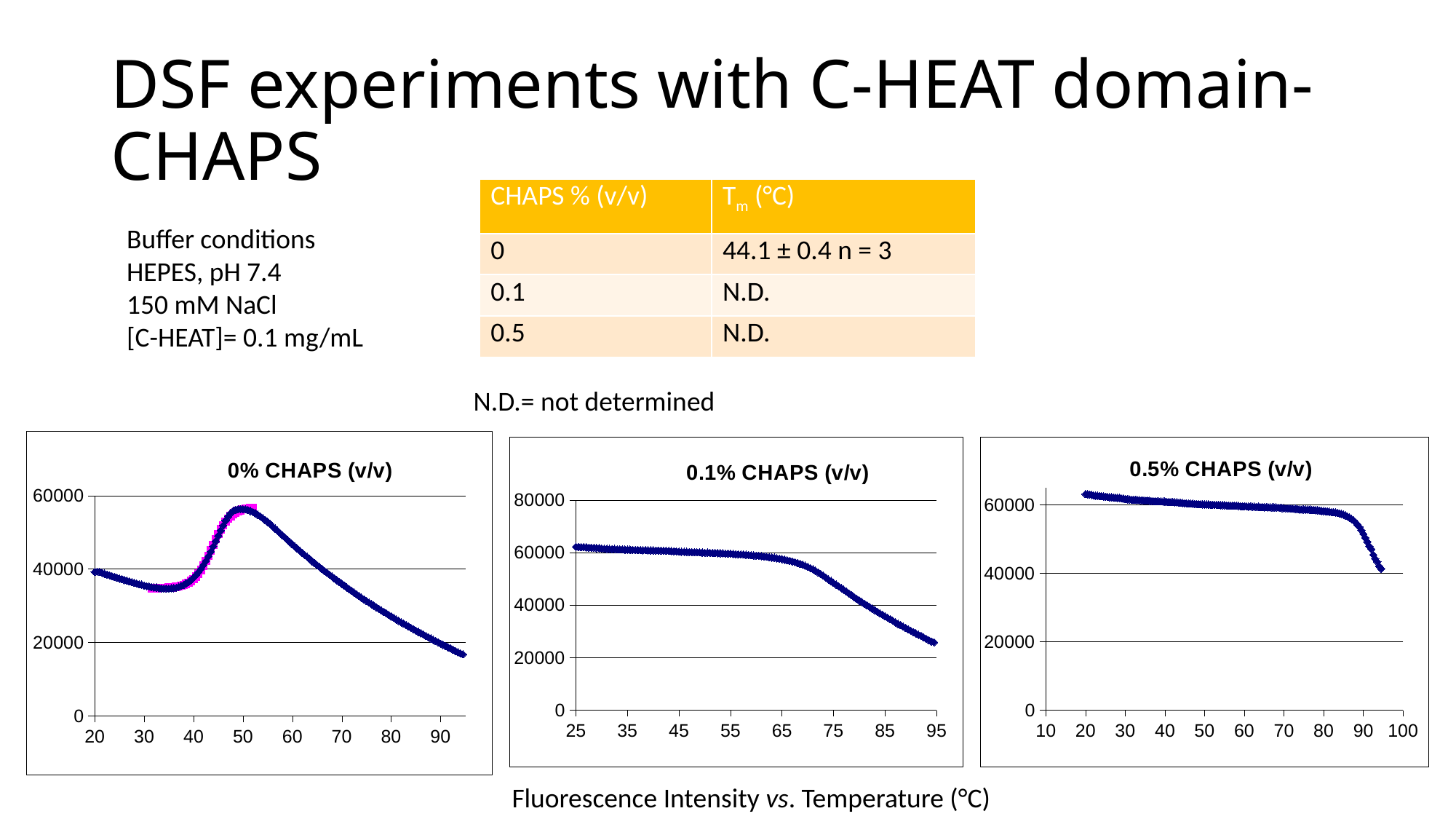
How many charts are shown on the slide? 3 In the '0.5% CHAPS (v/v)' chart, which is larger, the value at 20 or the value at 95? 20 What kind of chart is the '0% CHAPS (v/v)' chart? scatter chart What is the title of the rightmost chart? 0.5% CHAPS (v/v) In the '0% CHAPS (v/v)' chart, is the value at 50 greater or less than 60000? less In the '0% CHAPS (v/v)' chart, which x-axis tick is closest to the peak of the curve? 50 In the '0% CHAPS (v/v)' chart, is the value at 70 greater or less than 40000? less In the '0.1% CHAPS (v/v)' chart, do the values rise or fall as temperature increases along the x axis? fall In the '0.1% CHAPS (v/v)' chart, is the value at 95 greater or less than 20000? greater In the '0% CHAPS (v/v)' chart, do the values rise or fall between 50 and 90 on the x axis? fall